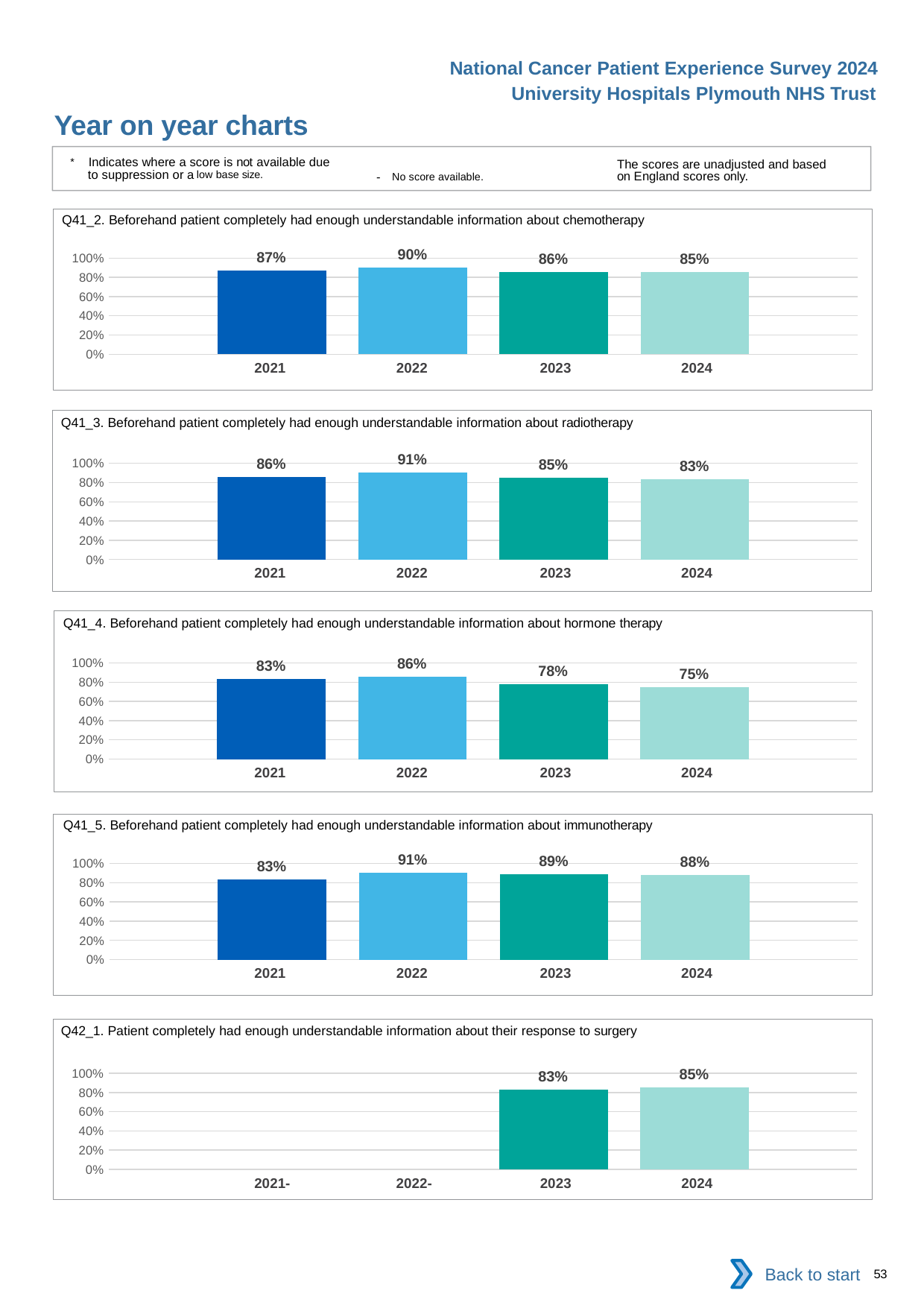
How many charts are shown on the slide? 5 In the Q41_2 chart (chemotherapy), what is the value for 2022? 90% In the Q41_4 chart (hormone therapy), what is the difference between the 2022 and 2024 values? 11% In the Q41_5 chart (immunotherapy), what is the difference between the 2022 and 2021 values? 8% In the Q42_1 chart (response to surgery), what is the value for 2024? 85% In the Q41_4 chart (hormone therapy), do the values rise or fall from 2022 to 2024? fall In the Q41_4 chart (hormone therapy), which year has the lowest value? 2024 What kind of chart is the Q41_2 chart (chemotherapy)? bar chart In the Q41_5 chart (immunotherapy), which is larger, the value for 2021 or the value for 2023? 2023 In the Q41_3 chart (radiotherapy), which year has the highest value? 2022 In the Q41_3 chart (radiotherapy), is the value for 2024 greater or less than 80%? greater In the Q42_1 chart (response to surgery), how many years have a bar plotted? 2